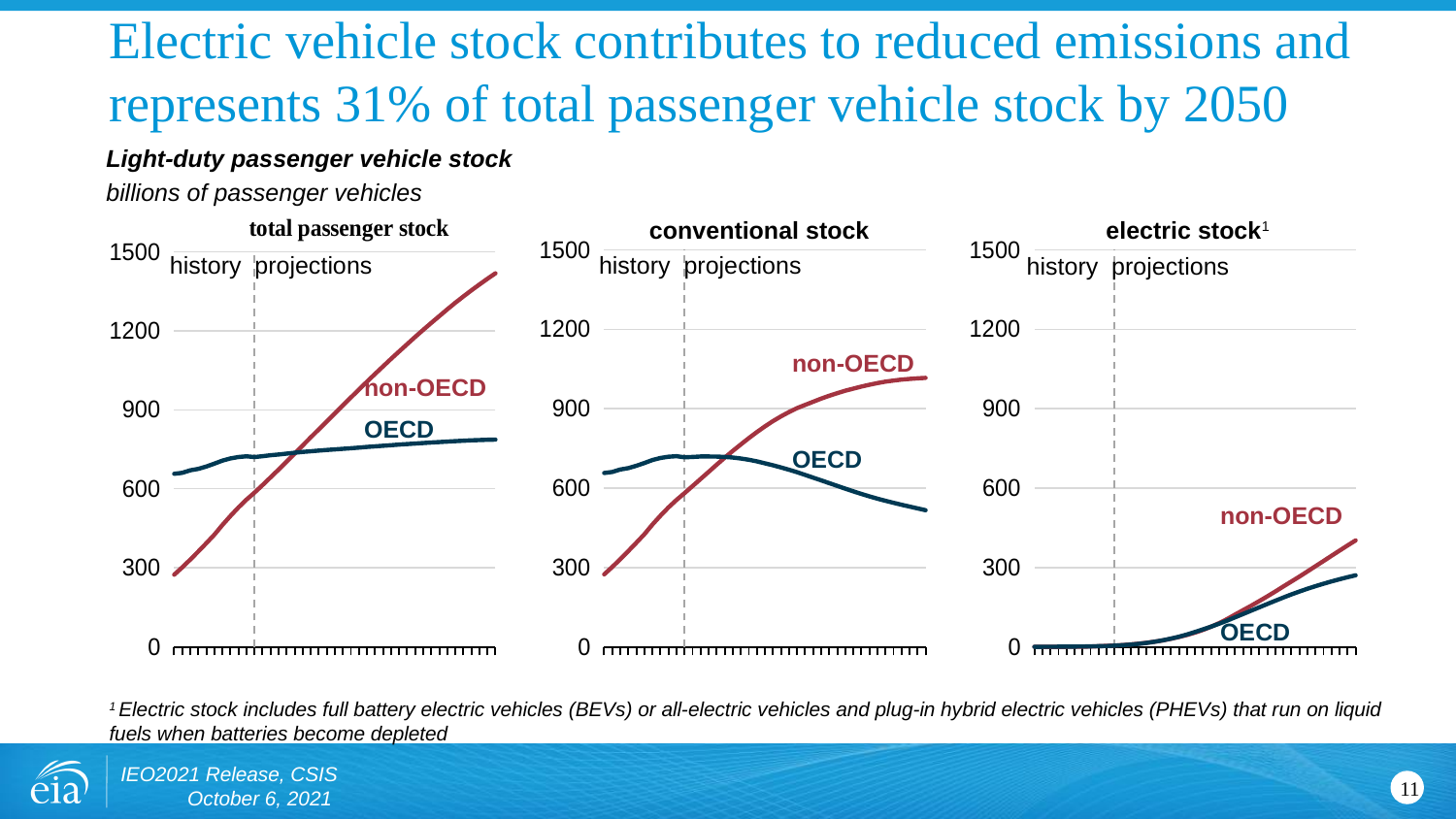
In the 'total passenger stock' chart, which series is higher at the end of the projection period, non-OECD or OECD? non-OECD In the 'conventional stock' chart, which series is higher at the start of the history period, non-OECD or OECD? OECD In the 'electric stock' chart, does the non-OECD line rise or fall over the projection period? rise In the 'total passenger stock' chart, is the OECD value at the end of the projection period greater or less than 900? less In the 'conventional stock' chart, is the OECD value at the end of the projection period greater or less than 600? less What colour is the non-OECD line in the charts? red In the 'conventional stock' chart, does the OECD line rise or fall over the projection period? fall How many series are plotted in the 'conventional stock' chart? 2 In the 'total passenger stock' chart, is the non-OECD value at the end of the projection period greater or less than 1200? greater What unit is given for the values in the charts? billions of passenger vehicles What kind of chart is the 'total passenger stock' chart? line chart